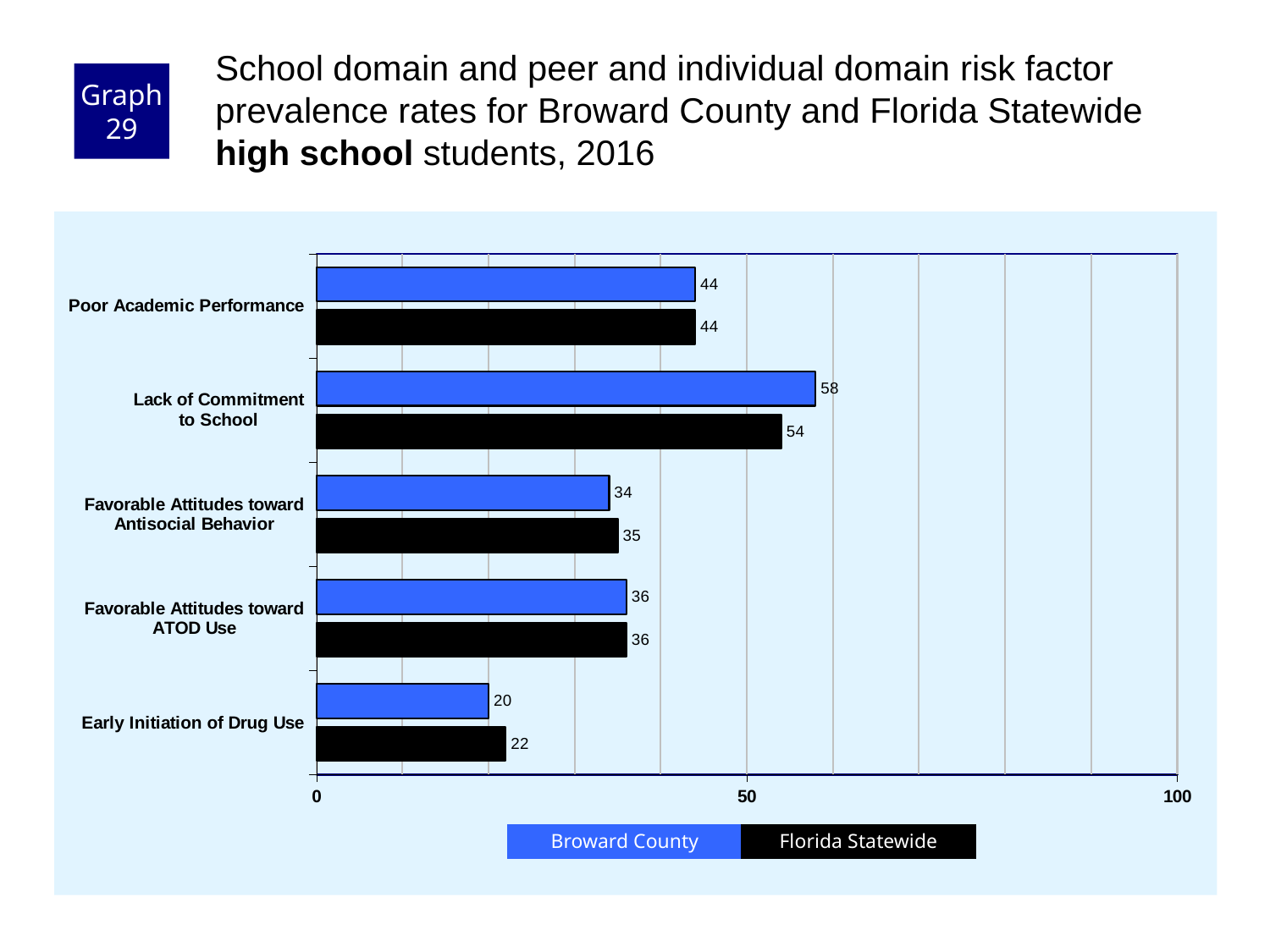
How many series does the legend list? 2 How many risk factor categories are shown on the chart? 5 Is the Broward County value for Lack of Commitment to School greater or less than 50? greater What is the difference between the Broward County and Florida Statewide values for Lack of Commitment to School? 4 Which colour represents Florida Statewide in the legend? Black What kind of chart is shown on the slide? Bar chart Which risk factor has the highest Broward County value? Lack of Commitment to School What is the Florida Statewide value for Favorable Attitudes toward Antisocial Behavior? 35 What is the Florida Statewide value for Early Initiation of Drug Use? 22 For Early Initiation of Drug Use, which is larger: the Broward County value or the Florida Statewide value? Florida Statewide What is the Broward County value for Lack of Commitment to School? 58 Which risk factor has the lowest Florida Statewide value? Early Initiation of Drug Use